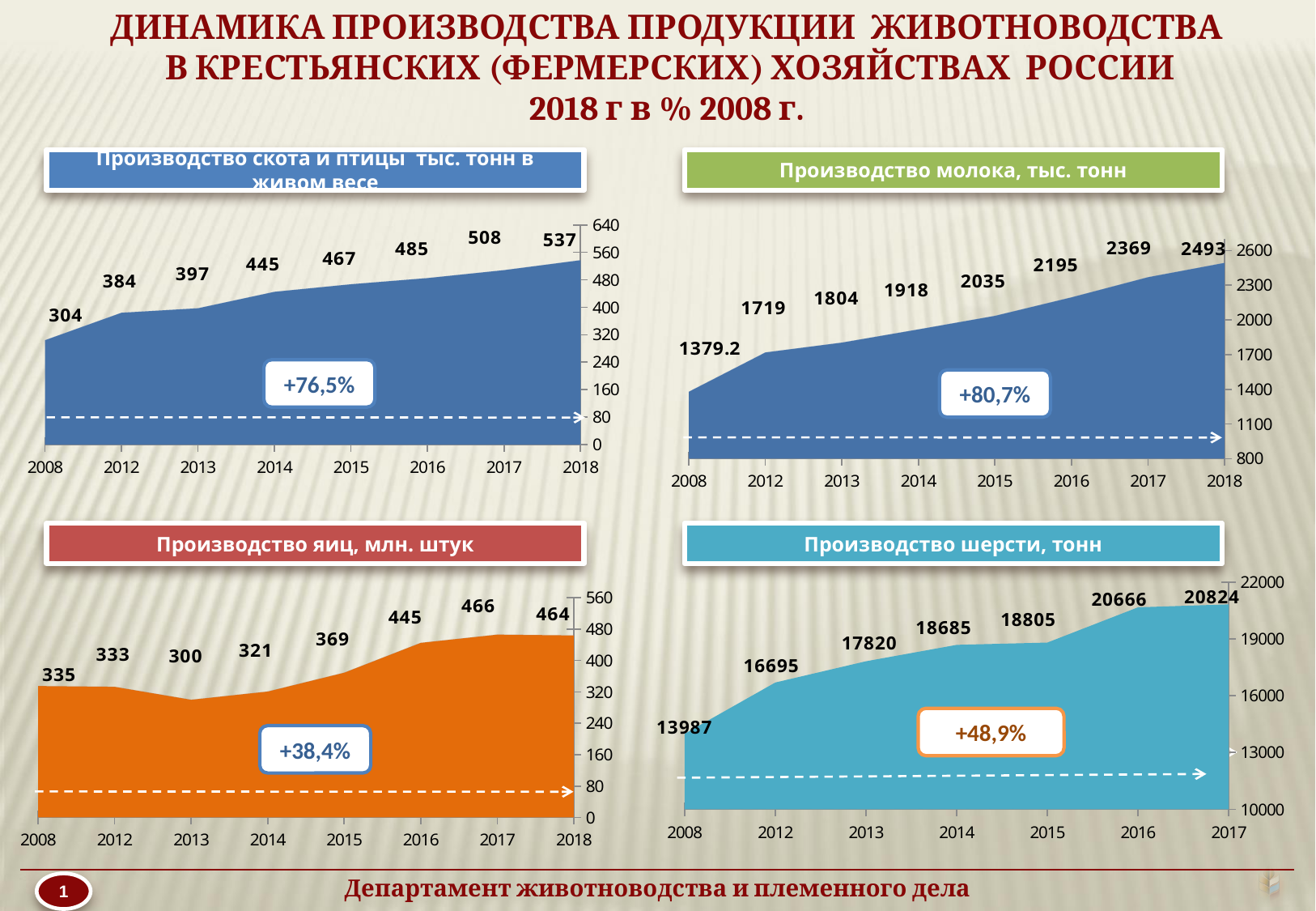
In the chart 'Производство скота и птицы, тыс. тонн в живом весе', what is the value for 2014? 445 In the chart 'Производство яиц, млн. штук', what is the difference between the 2016 and 2015 values? 76 In the chart 'Производство скота и птицы, тыс. тонн в живом весе', what is the difference between the 2018 and 2008 values? 233 In the chart 'Производство шерсти, тонн', what is the value for 2016? 20666 What type of chart is 'Производство шерсти, тонн'? Area chart In the chart 'Производство молока, тыс. тонн', which year has the highest value? 2018 In the chart 'Производство молока, тыс. тонн', what is the value for 2008? 1379.2 In the chart 'Производство яиц, млн. штук', which is larger, the value for 2017 or the value for 2018? 2017 In the chart 'Производство молока, тыс. тонн', how many years are plotted? 8 In the chart 'Производство яиц, млн. штук', what is the value for 2013? 300 In the chart 'Производство шерсти, тонн', how many years are plotted? 7 In the chart 'Производство скота и птицы, тыс. тонн в живом весе', which year has the lowest value? 2008